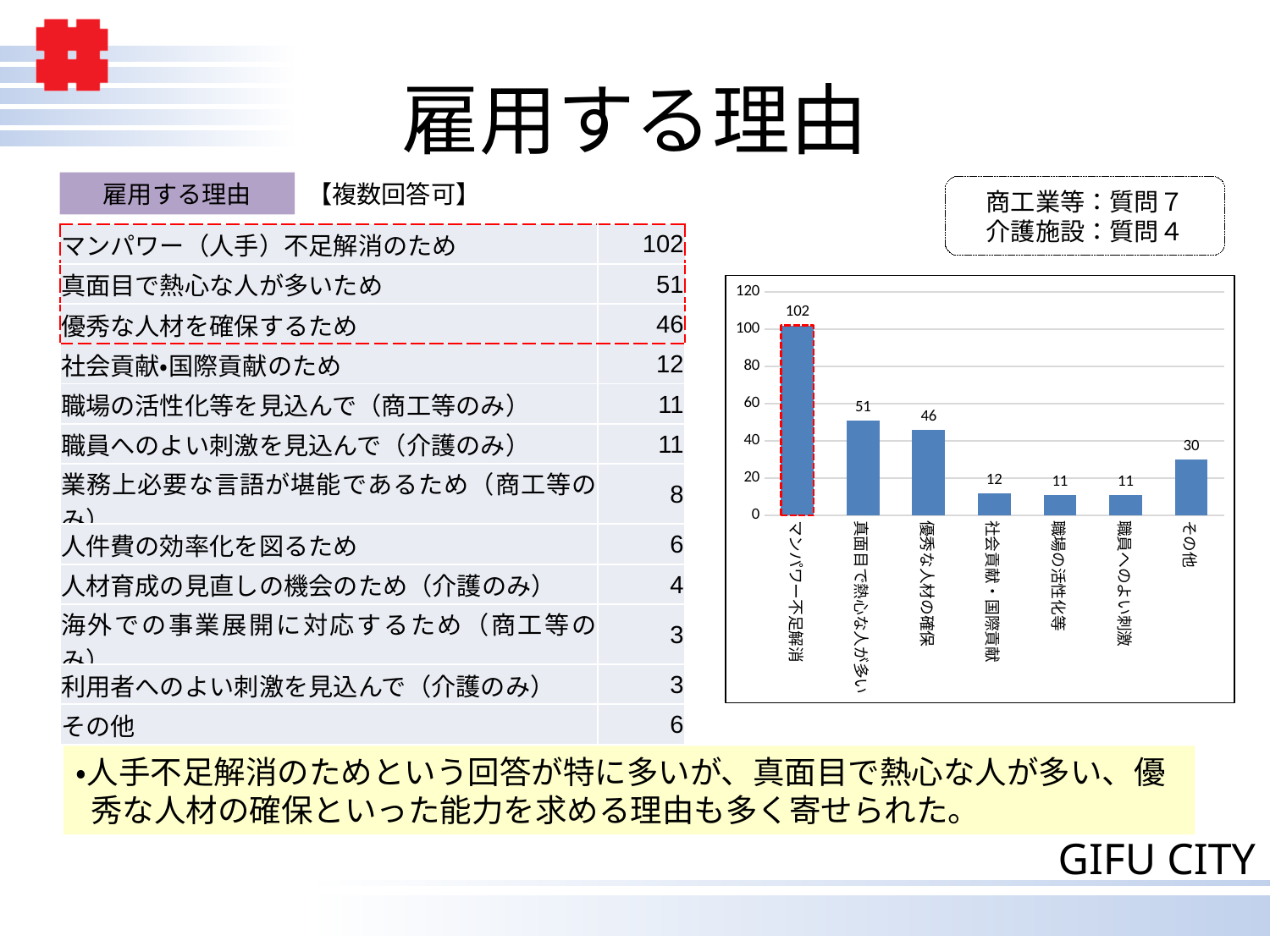
Which is larger, the value for その他 or the value for 社会貢献・国際貢献? その他 What is the value for 優秀な人材の確保 in the chart? 46 Which category has the highest value in the chart? マンパワー不足解消 What is the value for その他 in the chart? 30 Is the value for 真面目で熱心な人が多い greater or less than 40? greater What is the difference between the values for マンパワー不足解消 and 真面目で熱心な人が多い? 51 What kind of chart is shown on the slide? bar chart What is the value for 真面目で熱心な人が多い in the chart? 51 What is the highest value shown on the chart's vertical axis? 120 How many bars are shown in the chart? 7 What is the value for マンパワー不足解消 in the chart? 102 What is the difference between the values for 優秀な人材の確保 and 社会貢献・国際貢献? 34